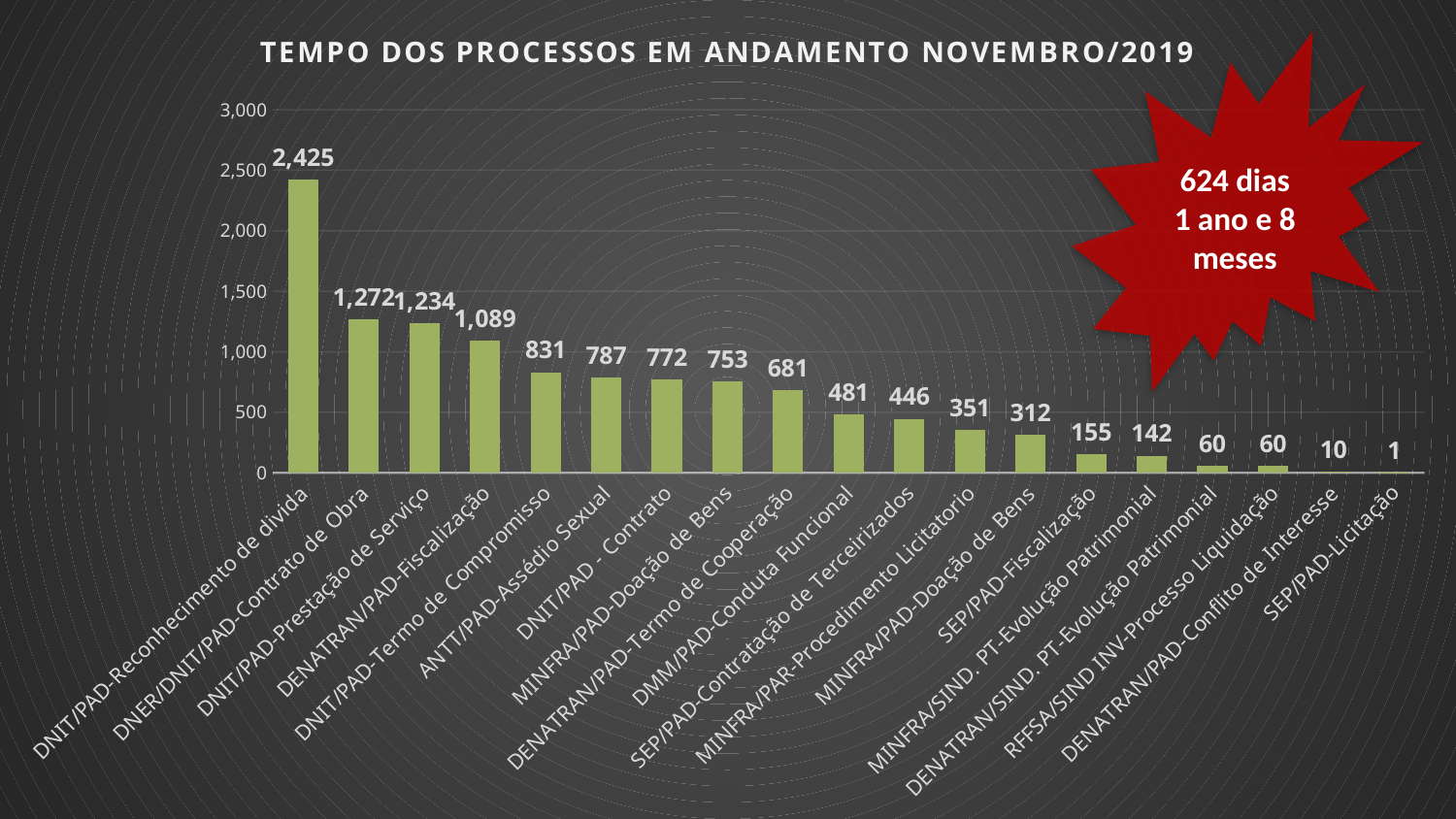
What is the value for DENATRAN/PAD-Fiscalização? 1,089 What is the value for DMM/PAD-Conduta Funcional? 481 Which category has the lowest value? SEP/PAD-Licitação What kind of chart is shown on the slide? bar chart How many categories are shown in the chart? 19 What is the title of the chart? TEMPO DOS PROCESSOS EM ANDAMENTO NOVEMBRO/2019 What is the value for SEP/PAD-Licitação? 1 Which category has the highest value? DNIT/PAD-Reconhecimento de dívida Which is larger, ANTT/PAD-Assédio Sexual or DNIT/PAD-Termo de Compromisso? DNIT/PAD-Termo de Compromisso Is the value for SEP/PAD-Contratação de Terceirizados greater or less than 500? less What is the value for DNIT/PAD-Reconhecimento de dívida? 2,425 What is the difference between DNER/DNIT/PAD-Contrato de Obra and DNIT/PAD-Prestação de Serviço? 38